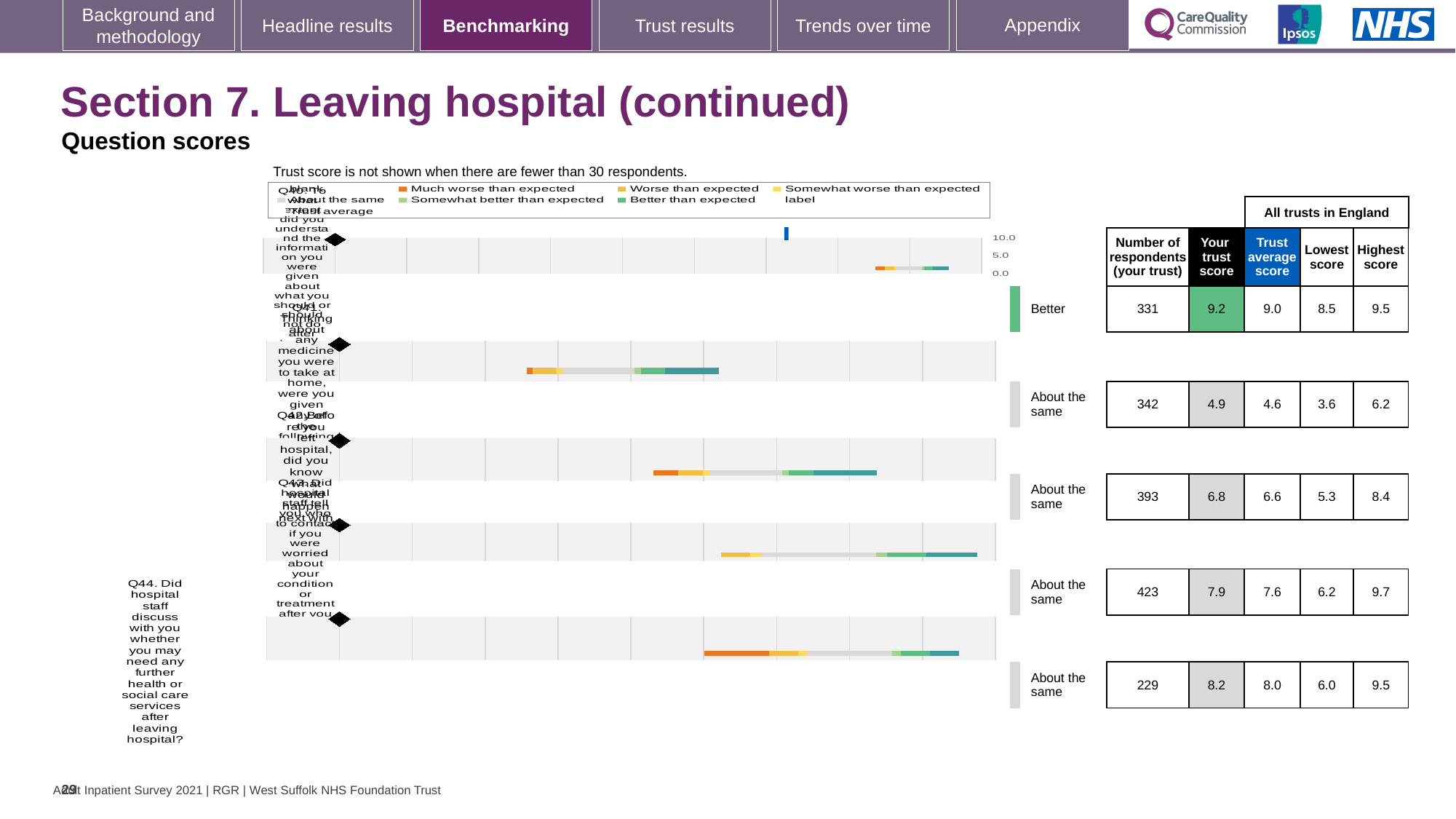
Which question row is rated 'Better' rather than 'About the same'? The top row What is the difference between the trust score and the trust average score for Q44? 0.2 What is the trust average score for Q44? 8.0 What is the trust score for Q44 (Did hospital staff discuss with you whether you may need any further health or social care services after leaving hospital?)? 8.2 How many question rows are plotted in the chart? 5 What colour represents 'Much worse than expected' in the legend? orange Which question row has the lowest trust score, and what is it? The second row, 4.9 What kind of chart is used to show the question scores on this slide? bar chart Which is larger for Q44, the trust score or the trust average score? trust score Which question row has the highest trust score, and what is it? The top row, 9.2 How many respondents answered Q44 at this trust? 229